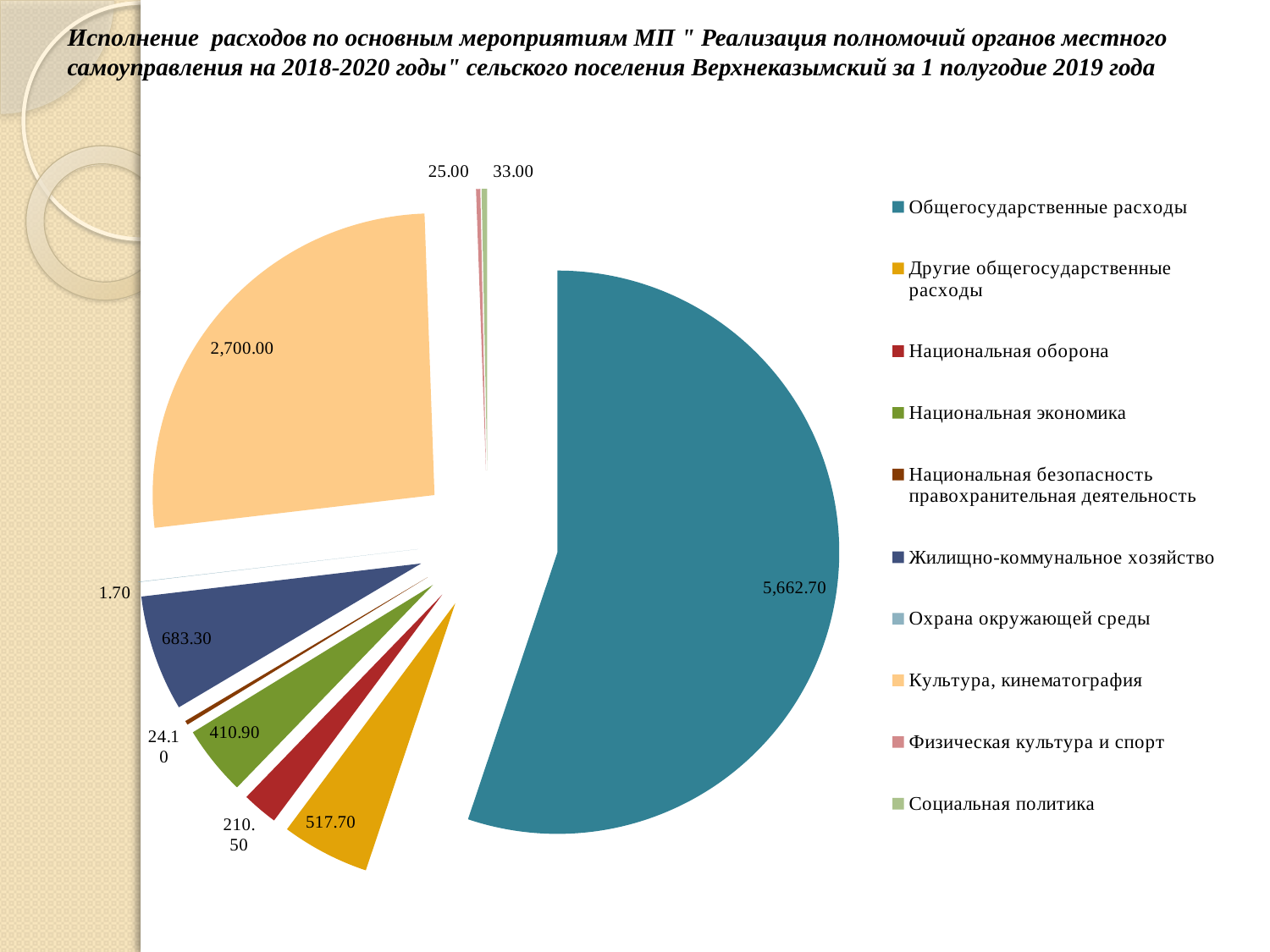
What colour is the slice for Общегосударственные расходы? teal Which category has the largest slice of the pie? Общегосударственные расходы What is the value for Культура, кинематография? 2,700.00 What kind of chart is shown on the slide? pie chart Which category has the smallest slice of the pie? Охрана окружающей среды What is the value for Охрана окружающей среды? 1.70 What is the value for Национальная экономика? 410.90 What is the difference between the values for Культура, кинематография and Жилищно-коммунальное хозяйство? 2,016.70 Which is larger: the value for Другие общегосударственные расходы or the value for Национальная экономика? Другие общегосударственные расходы What is the value for Общегосударственные расходы? 5,662.70 How many categories does the legend of the pie chart list? 10 What is the value for Жилищно-коммунальное хозяйство? 683.30